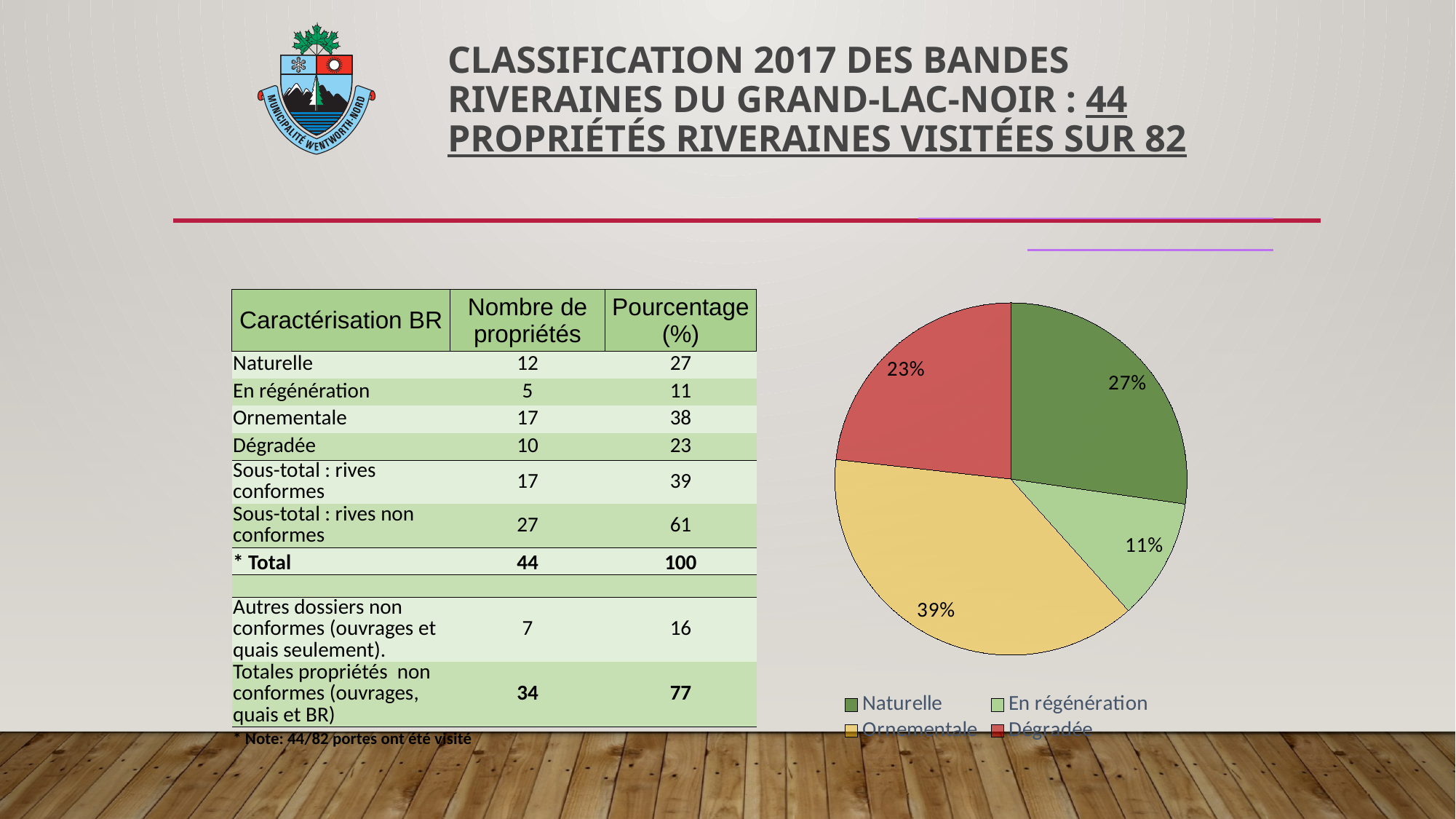
In the pie chart, what share does the Ornementale slice represent? 39% What colour is the Dégradée slice in the pie chart? red What kind of chart is shown on the slide? pie chart Which category has the largest slice in the pie chart? Ornementale How many entries does the pie chart legend list? 4 Which category has the smallest slice in the pie chart? En régénération In the pie chart, what share does the Dégradée slice represent? 23% What is the difference in percentage points between the Ornementale and Dégradée slices? 16 In the pie chart, what share does the En régénération slice represent? 11% In the pie chart, what share does the Naturelle slice represent? 27% How many slices does the pie chart have? 4 Which slice is larger in the pie chart, Naturelle or Dégradée? Naturelle